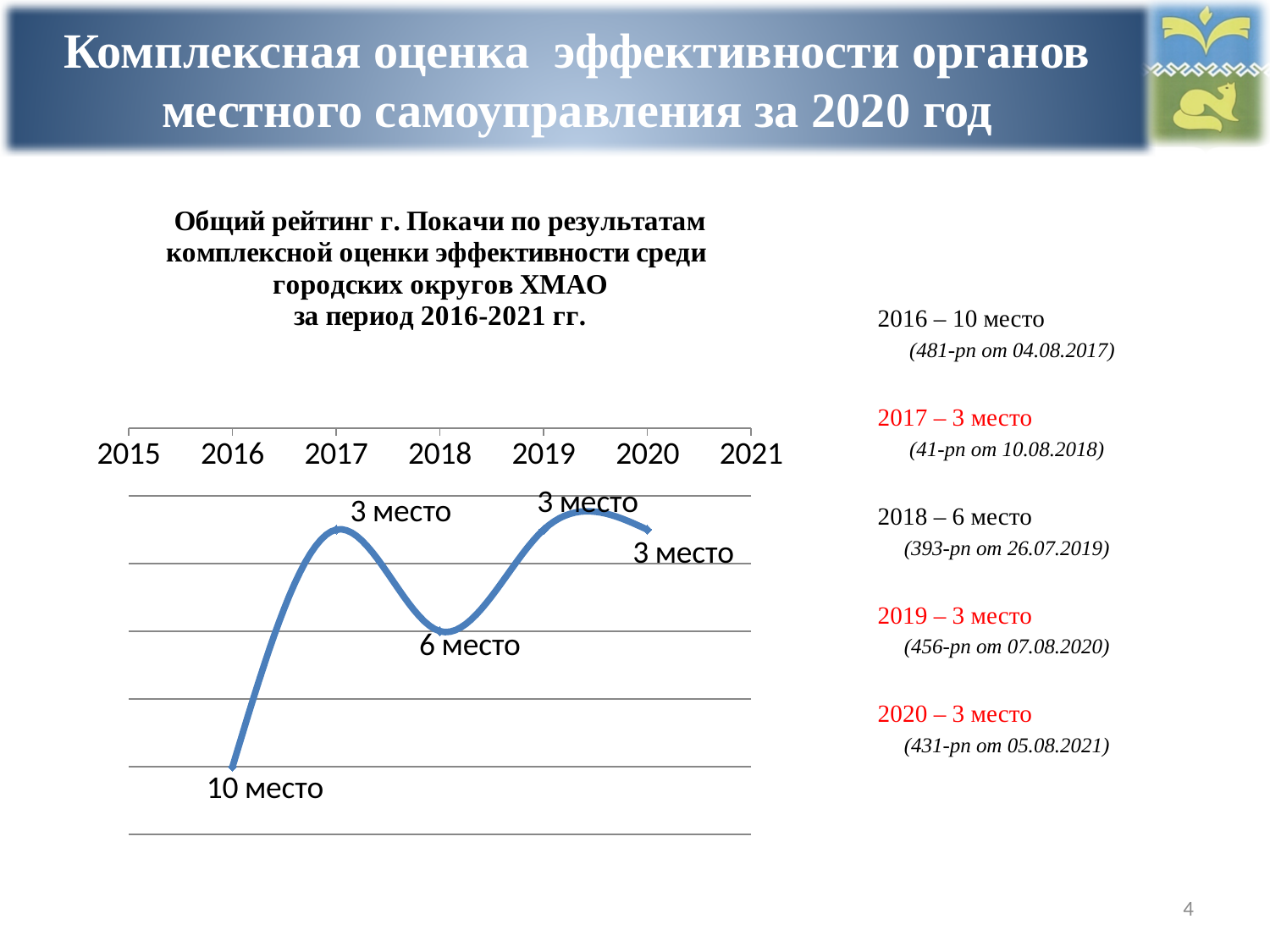
What place is shown for 2017 on the chart? 3 место What place is shown for 2018 on the chart? 6 место Which year has the larger place number, 2017 or 2018? 2018 Does the place number rise or fall from 2016 to 2017? Fall What kind of chart is shown on the slide? Line chart What place did Pokachi hold in 2016 according to the chart? 10 место By how many places does the 2018 value differ from the 2019 value? 3 What place is shown for 2020 on the chart? 3 место By how many places does the 2016 value differ from the 2017 value? 7 How many data points with labels are plotted on the chart? 5 What is the first year label shown on the x axis of the chart? 2015 In which year does the chart show the largest place number (the worst ranking)? 2016